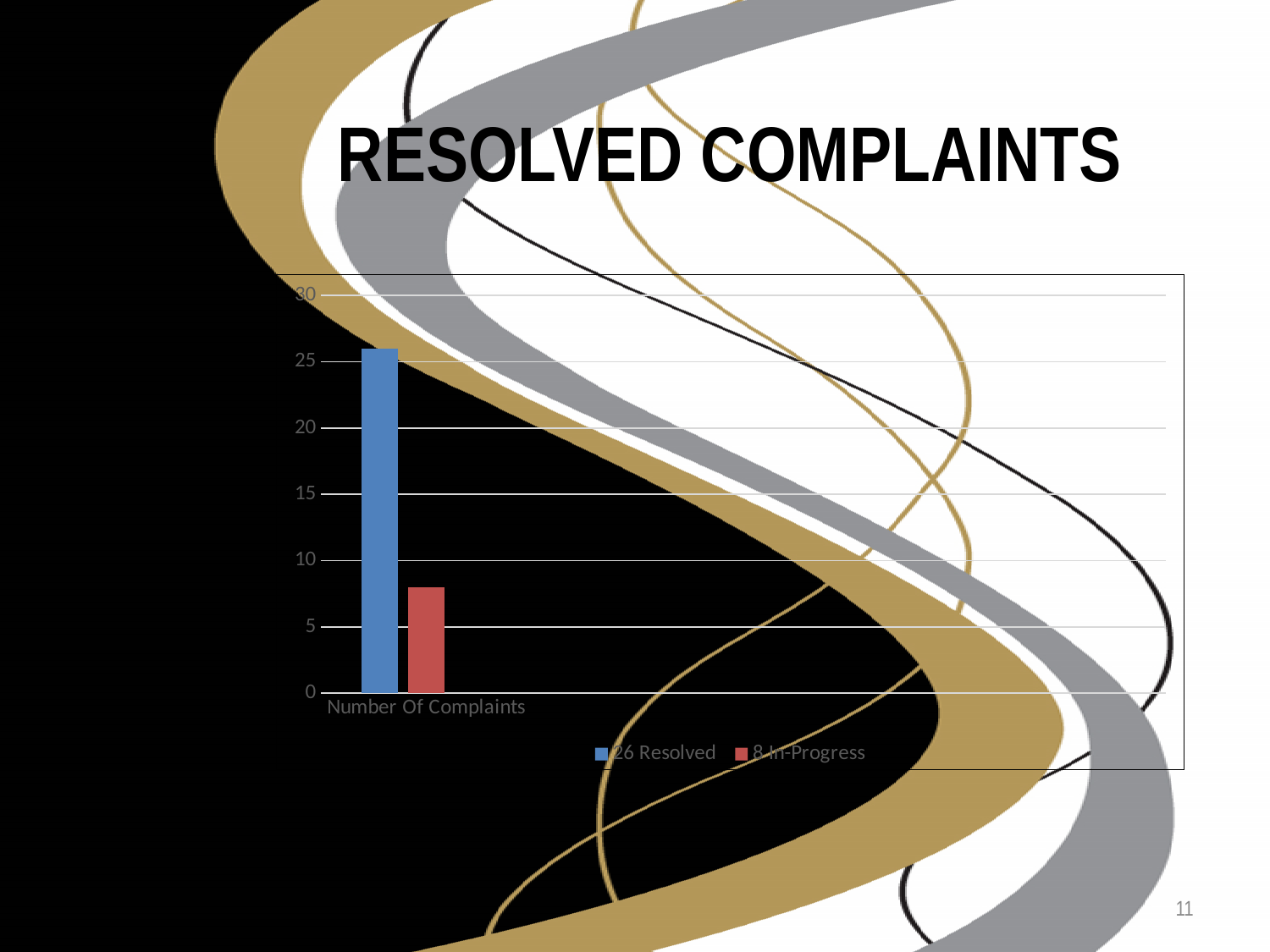
What is the value of the '8 In-Progress' bar for Number Of Complaints? 8 Which is larger, the Resolved bar or the In-Progress bar? Resolved How many series does the legend list? 2 Which series has the highest bar? 26 Resolved What is the difference between the Resolved value and the In-Progress value? 18 Which series has the lowest bar? 8 In-Progress Is the value for the In-Progress bar greater or less than 10? less What kind of chart is shown on the slide? bar chart How many categories are shown on the x axis? 1 What is the title of the slide above the chart? RESOLVED COMPLAINTS What is the value of the '26 Resolved' bar for Number Of Complaints? 26 Is the value for the Resolved bar greater or less than 20? greater